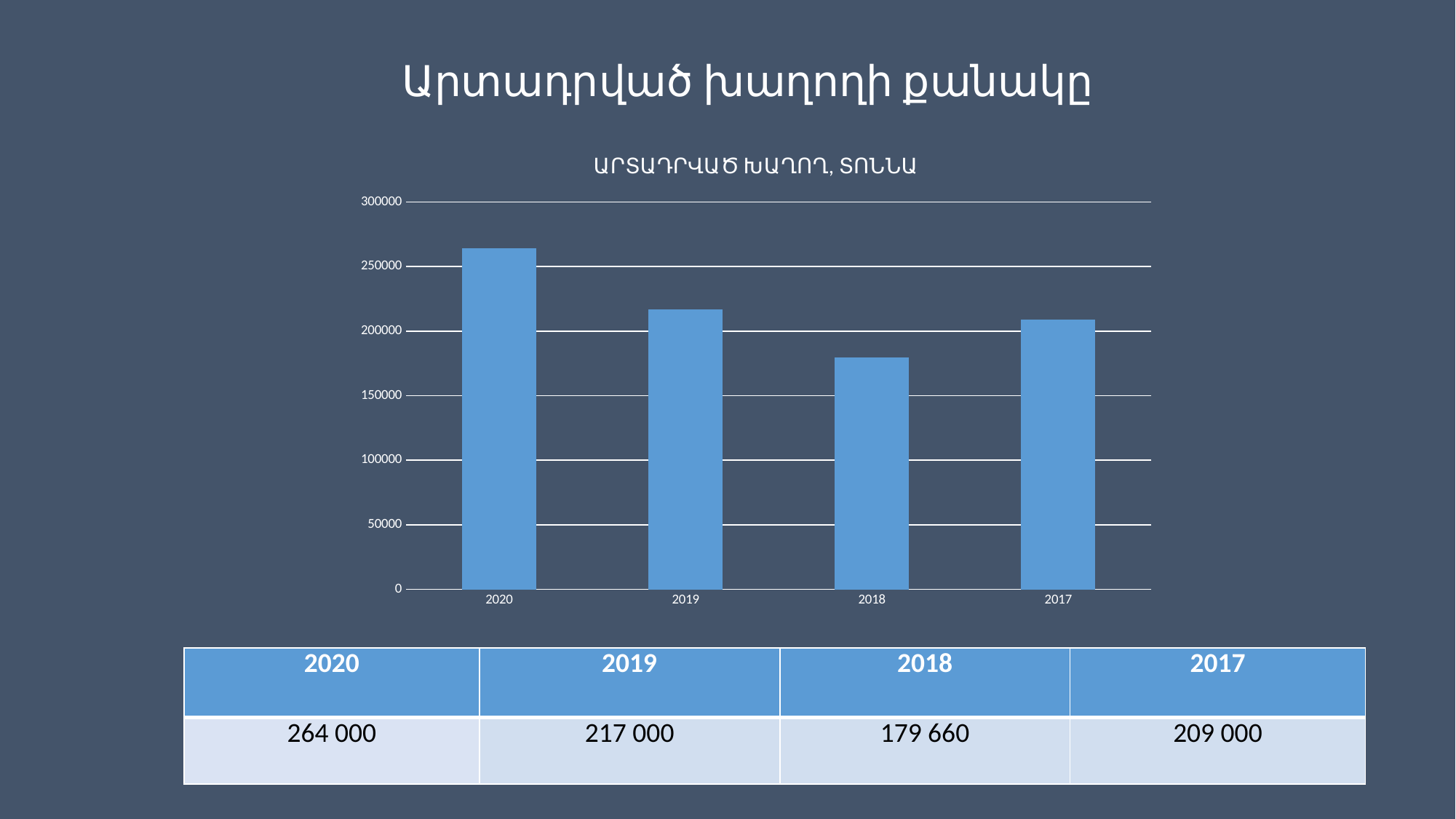
How many years are shown on the x axis of the chart? 4 What is the value for 2018 in the chart? 179 660 What kind of chart is shown on the slide? bar chart Is the value for 2018 greater or less than 200000? less What is the difference between the values for 2017 and 2018? 29 340 What is the value for 2017 in the chart? 209 000 Which year has the lowest value in the chart? 2018 What is the title of the chart? ԱՐՏԱԴՐՎԱԾ ԽԱՂՈՂ, ՏՈՆՆԱ Which is larger, the value for 2019 or the value for 2017? 2019 What is the difference between the values for 2020 and 2019? 47 000 What is the value for 2020 in the chart? 264 000 Which year has the highest value in the chart? 2020